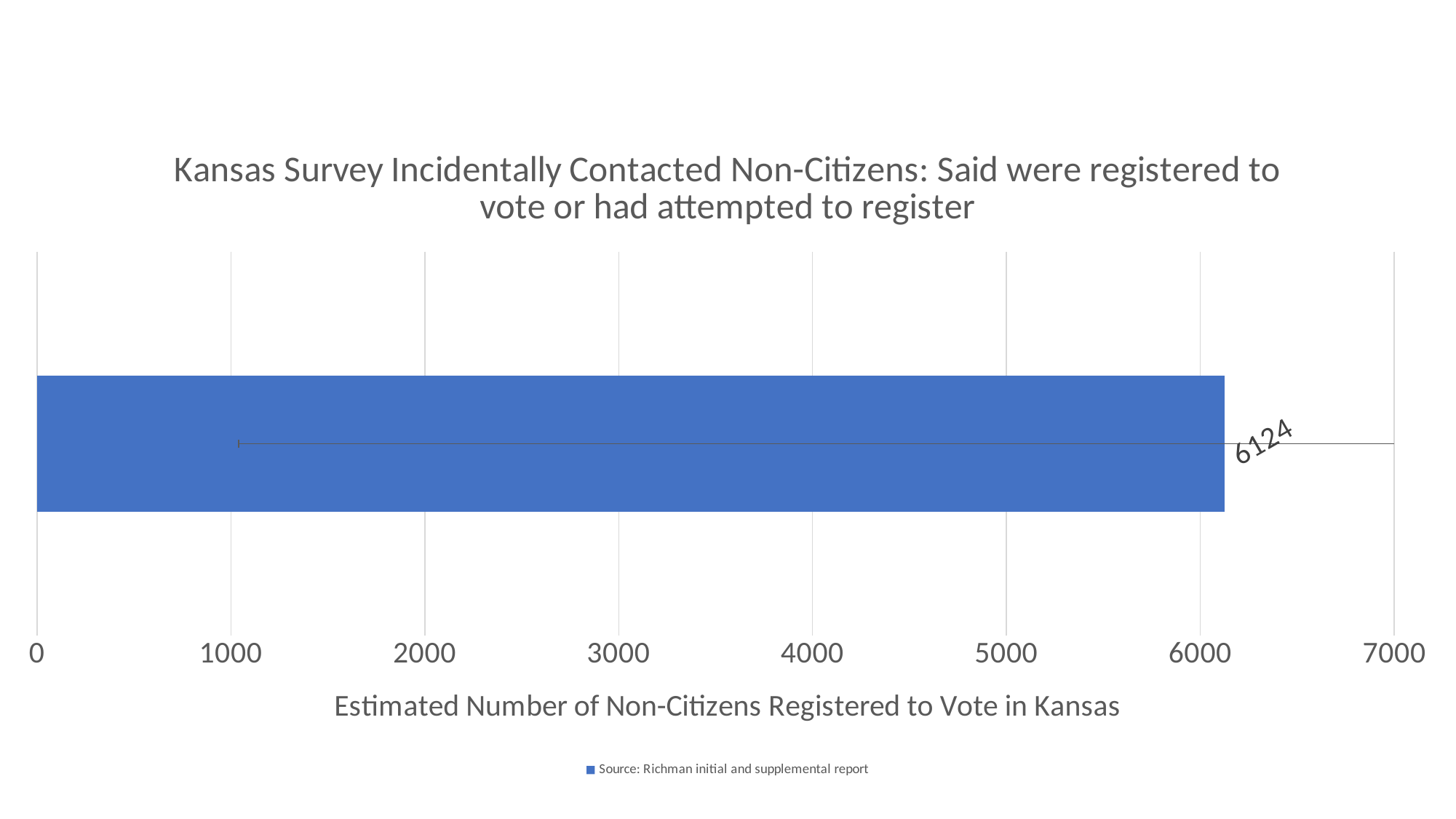
Is the value of the bar greater or less than 7000? less What kind of chart is shown on the slide? bar chart What is the title of the horizontal axis? Estimated Number of Non-Citizens Registered to Vote in Kansas How many bars are plotted in the chart? 1 Is the value of the bar greater or less than 6000? greater What is the highest value shown on the horizontal axis? 7000 Is the value of the bar greater or less than 5000? greater What value is shown by the data label on the bar? 6124 How many series does the legend list? 1 What does the legend entry say? Source: Richman initial and supplemental report